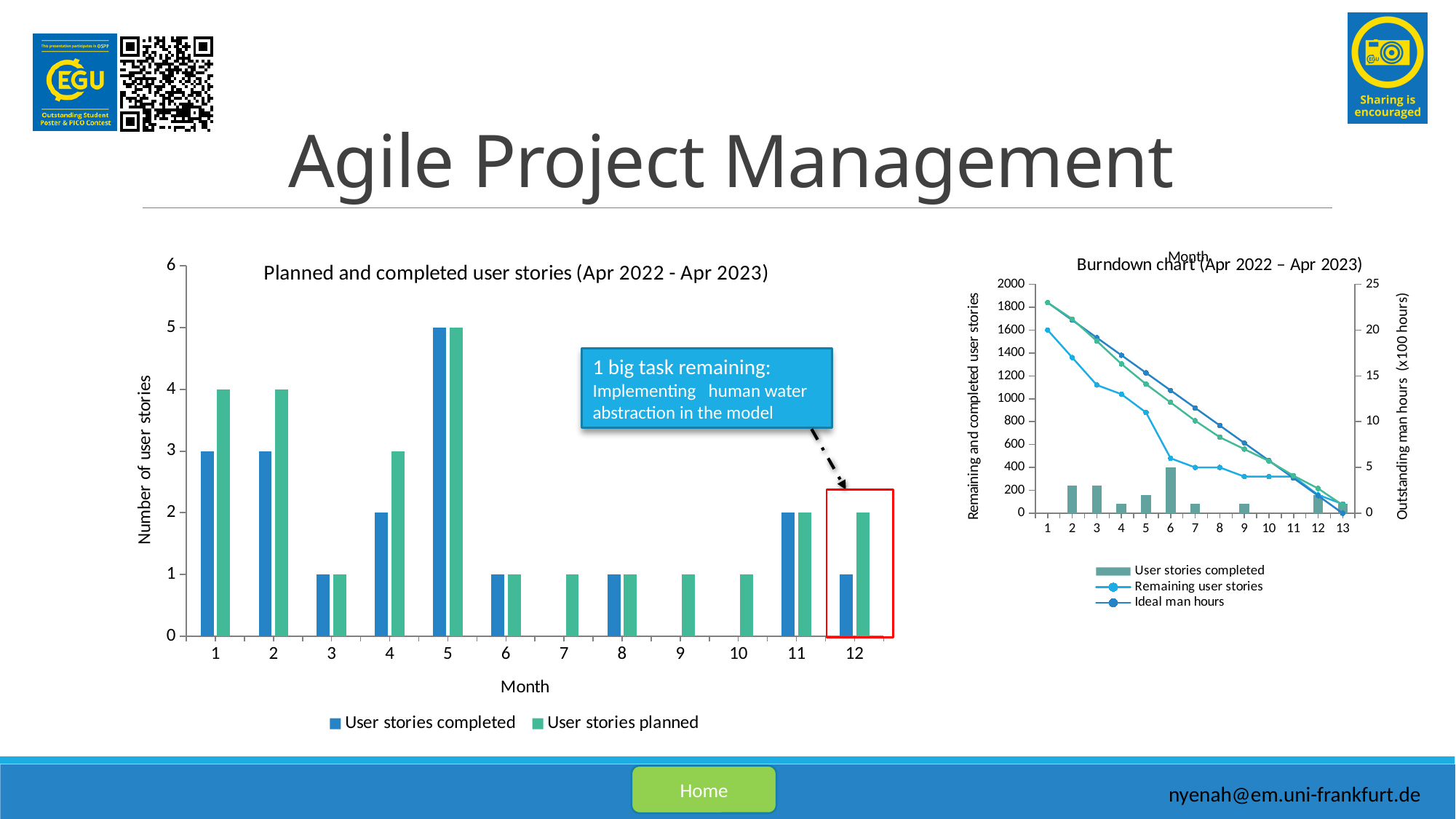
In the chart 'Planned and completed user stories (Apr 2022 - Apr 2023)', how many series does the legend list? 2 In the 'Burndown chart (Apr 2022 – Apr 2023)', is the value of Remaining user stories at month 6 greater or less than 600? less In the chart 'Planned and completed user stories (Apr 2022 - Apr 2023)', which month has the highest number of user stories completed? 5 In the 'Burndown chart (Apr 2022 – Apr 2023)', do the remaining user stories rise or fall from month 1 to month 13? Fall In the 'Burndown chart (Apr 2022 – Apr 2023)', how many series does the legend list? 3 In the chart 'Planned and completed user stories (Apr 2022 - Apr 2023)', how many user stories were planned in month 1? 4 In the 'Burndown chart (Apr 2022 – Apr 2023)', is the value of Ideal man hours at month 1 greater or less than 20? greater In the chart 'Planned and completed user stories (Apr 2022 - Apr 2023)', which is larger in month 2: user stories planned or user stories completed? User stories planned In the chart 'Planned and completed user stories (Apr 2022 - Apr 2023)', what is the difference between user stories planned and user stories completed in month 12? 1 What kind of chart is 'Planned and completed user stories (Apr 2022 - Apr 2023)'? Bar chart In the chart 'Planned and completed user stories (Apr 2022 - Apr 2023)', how many months are shown on the x axis? 12 In the chart 'Planned and completed user stories (Apr 2022 - Apr 2023)', how many user stories were completed in month 4? 2